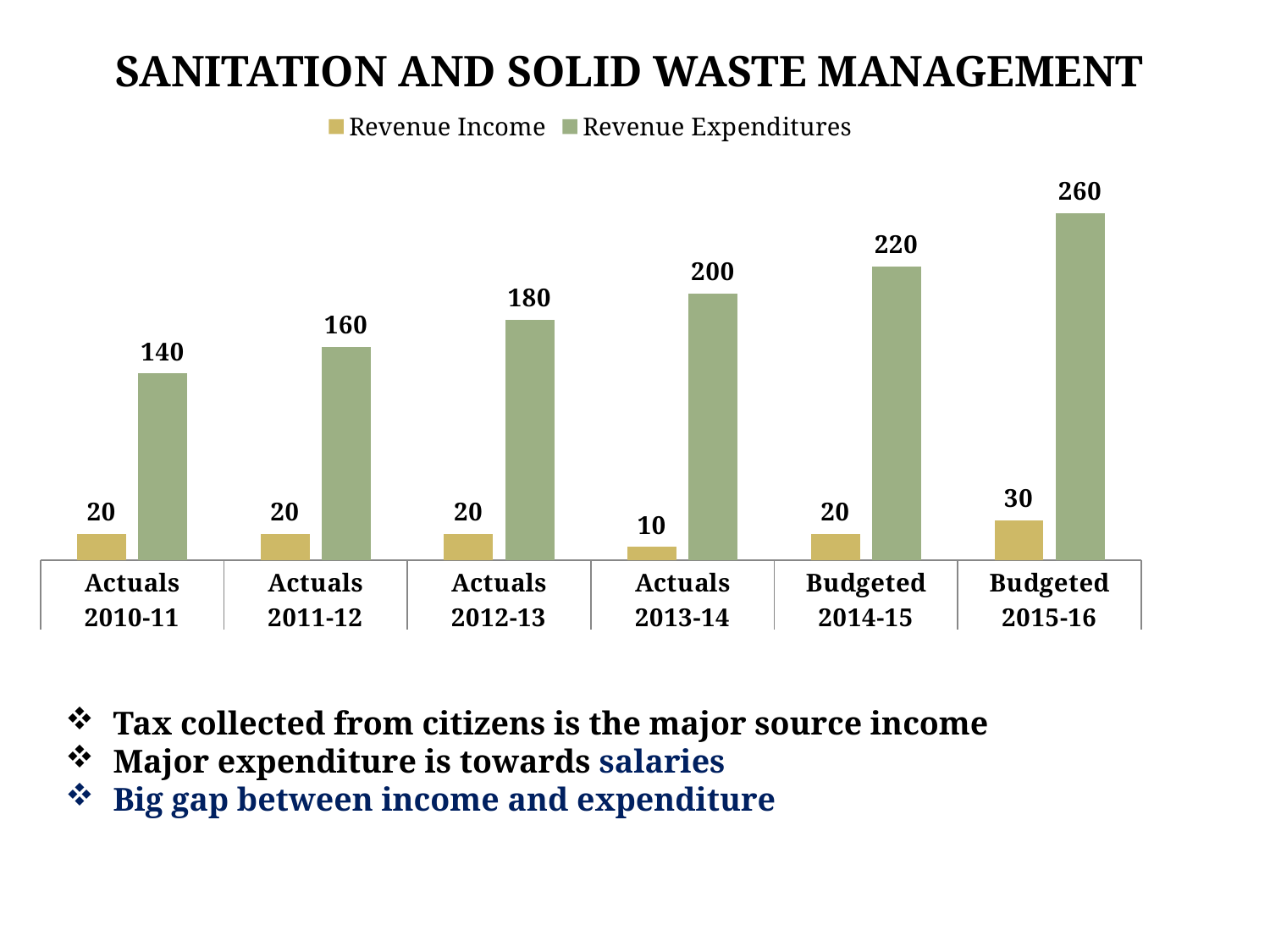
Which category has the highest Revenue Expenditures? Budgeted 2015-16 What is the Revenue Income value for Budgeted 2015-16? 30 Do the Revenue Expenditures values rise or fall from Actuals 2010-11 to Budgeted 2015-16? Rise How many categories are shown on the x axis? 6 What is the title of the slide containing the chart? SANITATION AND SOLID WASTE MANAGEMENT How many series does the legend list? 2 Which is larger: Revenue Expenditures for Actuals 2011-12 or Revenue Expenditures for Actuals 2012-13? Actuals 2012-13 Which category has the lowest Revenue Income? Actuals 2013-14 What kind of chart is shown on the slide? Bar chart What is the Revenue Income value for Actuals 2013-14? 10 What is the difference between Revenue Expenditures and Revenue Income for Budgeted 2014-15? 200 What is the Revenue Expenditures value for Actuals 2013-14? 200